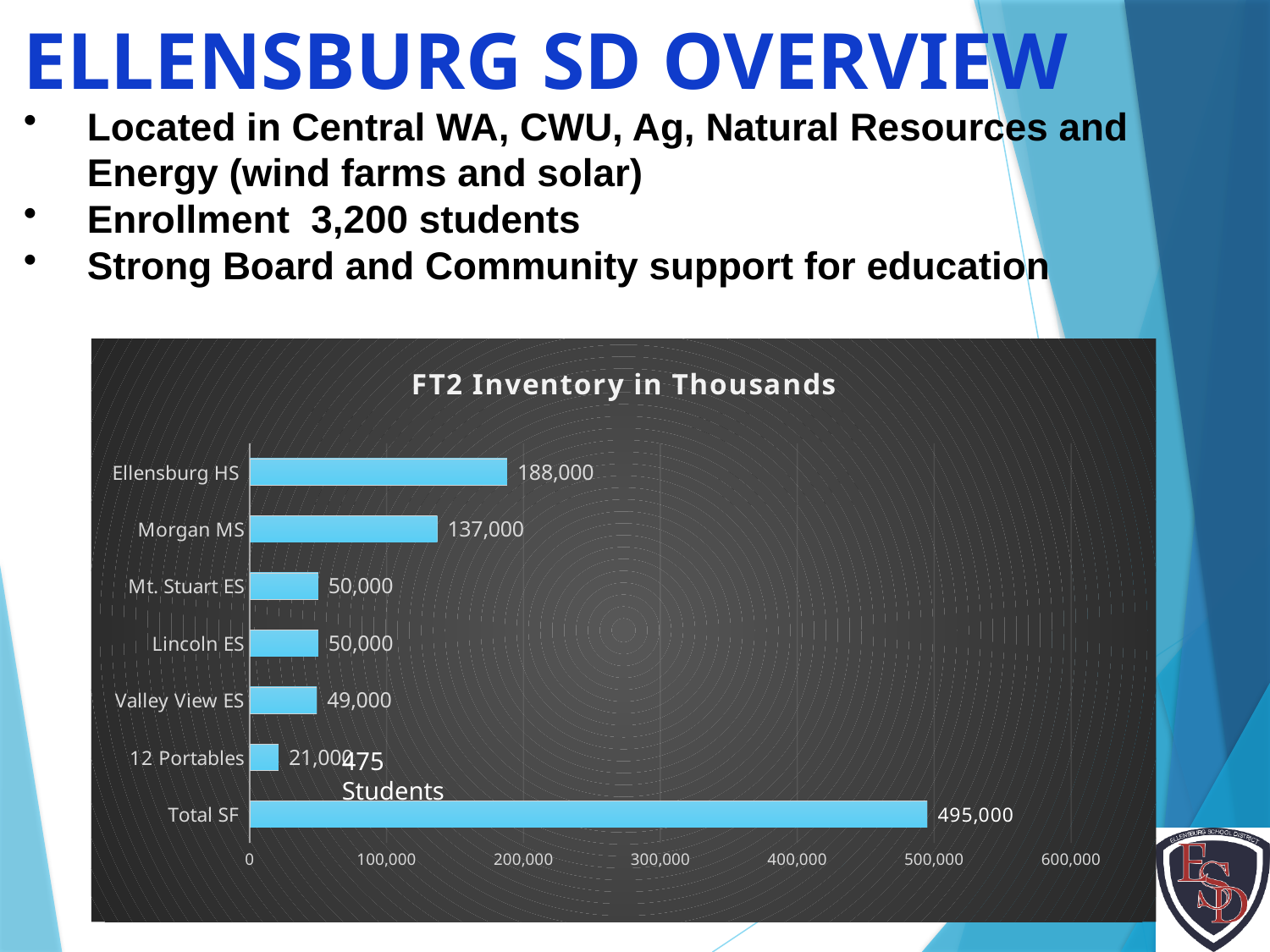
Which is larger, the value for Morgan MS or the value for Mt. Stuart ES? Morgan MS What is the title of the chart? FT2 Inventory in Thousands What is the value for Total SF? 495,000 What is the value for Ellensburg HS? 188,000 What is the value for 12 Portables? 21,000 How many categories are shown on the chart? 7 What is the difference between the values for Ellensburg HS and Morgan MS? 51,000 What is the value for Morgan MS? 137,000 Which category has the highest value? Total SF Which category has the lowest value? 12 Portables Is the value for Ellensburg HS greater or less than 200,000? less What kind of chart is shown on the slide? Bar chart